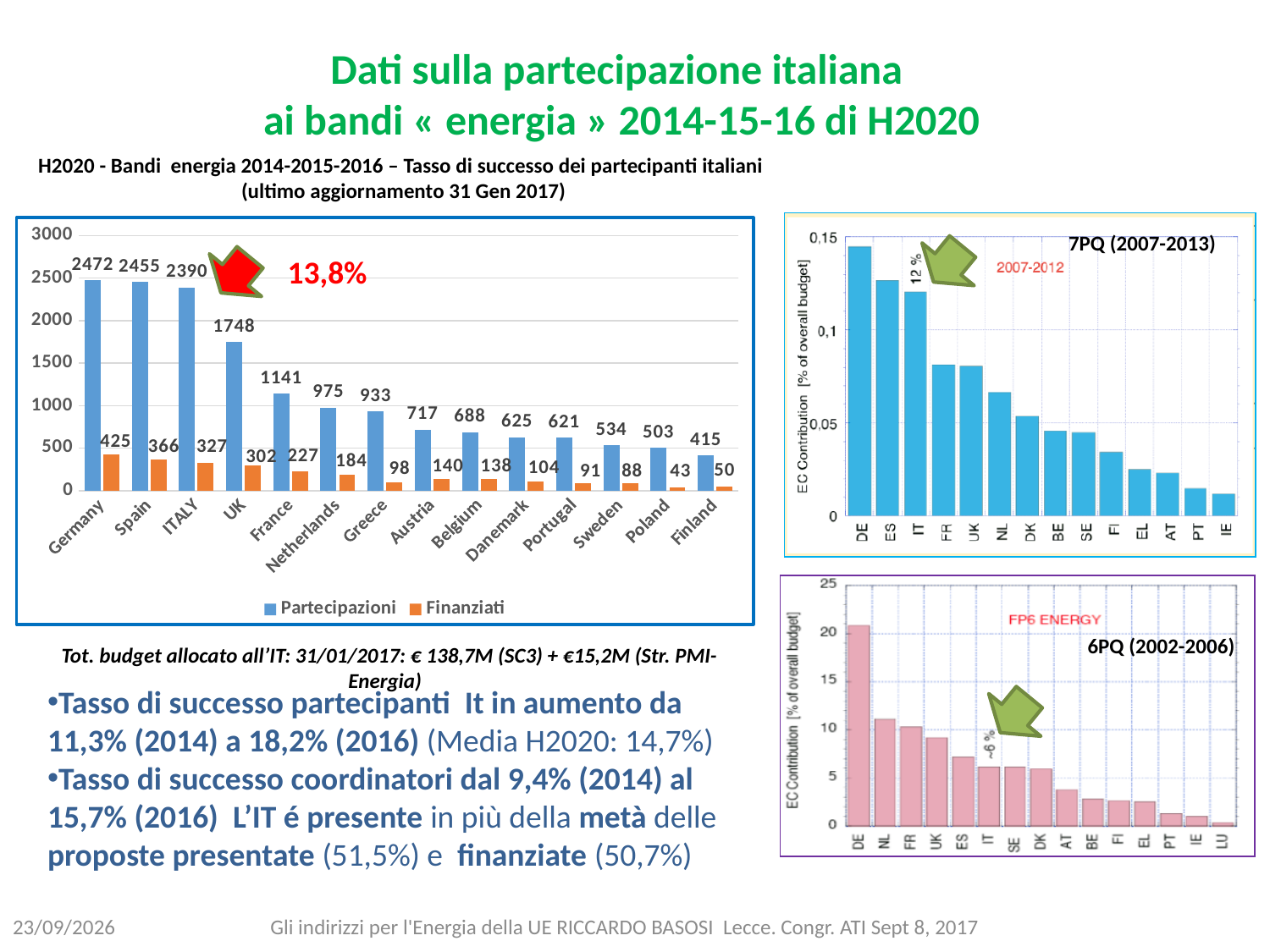
In the H2020 bar chart on the left, how many series does the legend list? 2 In the 6PQ (2002-2006) chart on the right, which country has the highest EC Contribution? DE In the H2020 bar chart on the left, what is the Finanziati value for ITALY? 327 In the H2020 bar chart on the left, what is the Finanziati value for Poland? 43 In the H2020 bar chart on the left, which country has the highest Finanziati value? Germany In the H2020 bar chart on the left, which country has the lowest Partecipazioni value? Finland In the H2020 bar chart on the left, what is the difference between the Partecipazioni values for UK and France? 607 In the H2020 bar chart on the left, what is the Partecipazioni value for Germany? 2472 What kind of chart is the 6PQ (2002-2006) chart on the right? bar chart In the 7PQ (2007-2013) chart on the right, is the EC Contribution value for DE greater or less than 0.1? greater In the H2020 bar chart on the left, how many countries are shown on the x axis? 14 In the H2020 bar chart on the left, which is larger: the Finanziati value for Austria or for Belgium? Austria